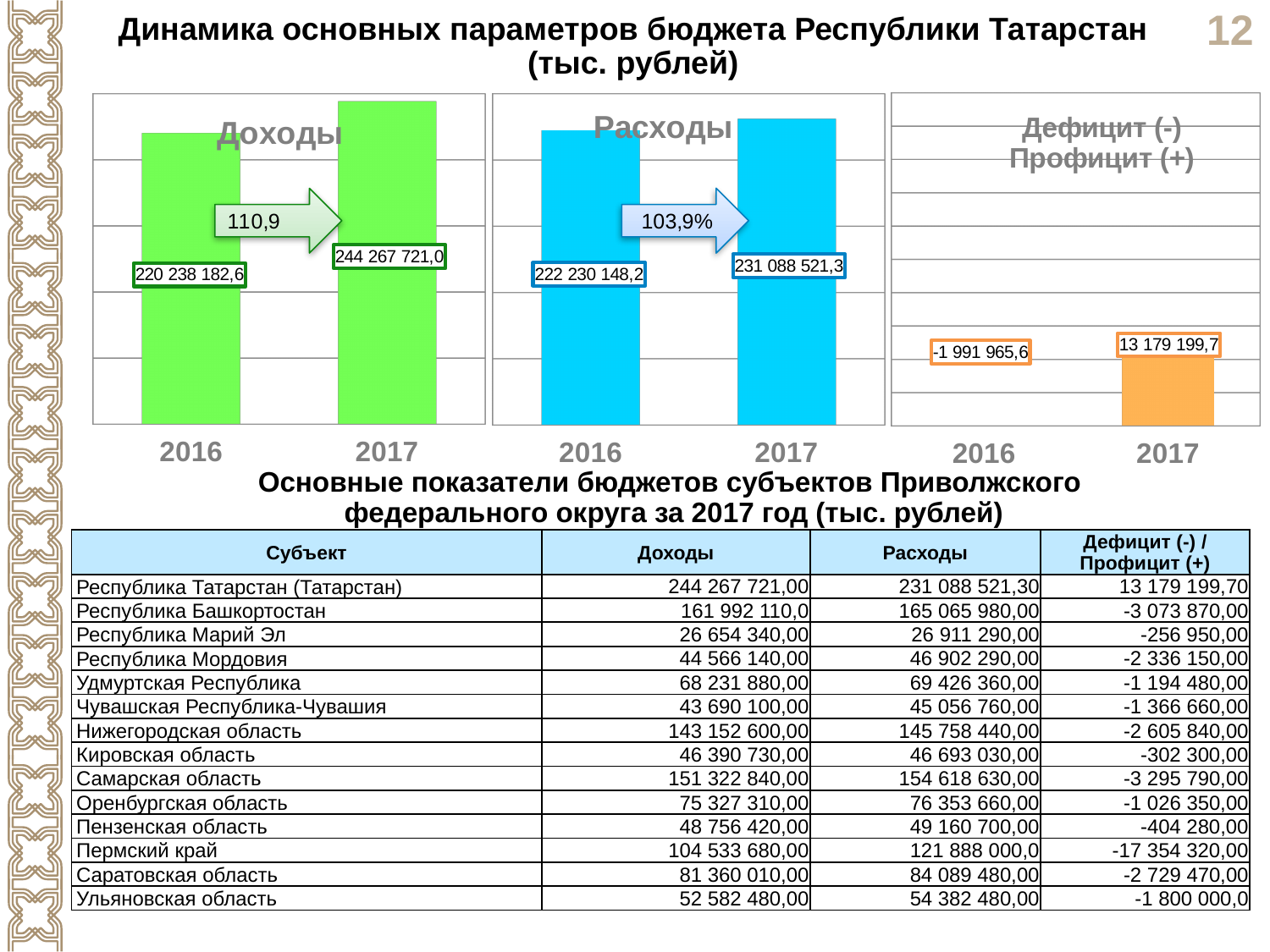
How many years are shown in the Доходы chart? 2 In the Расходы chart, what is the difference between the 2017 and 2016 values? 8 858 373,1 In the Дефицит (-) Профицит (+) chart, what is the value for 2016? -1 991 965,6 In the Дефицит (-) Профицит (+) chart, what is the value for 2017? 13 179 199,7 What kind of chart is the Расходы chart? Bar chart In the Доходы chart, what is the value for 2016? 220 238 182,6 In the Доходы chart, which year has the higher value, 2016 or 2017? 2017 In the Расходы chart, what is the value for 2016? 222 230 148,2 In the Доходы chart, what is the difference between the 2017 and 2016 values? 24 029 538,4 In the Доходы chart, what is the value for 2017? 244 267 721,0 What percentage is shown on the arrow in the Расходы chart? 103,9% In the Расходы chart, what is the value for 2017? 231 088 521,3